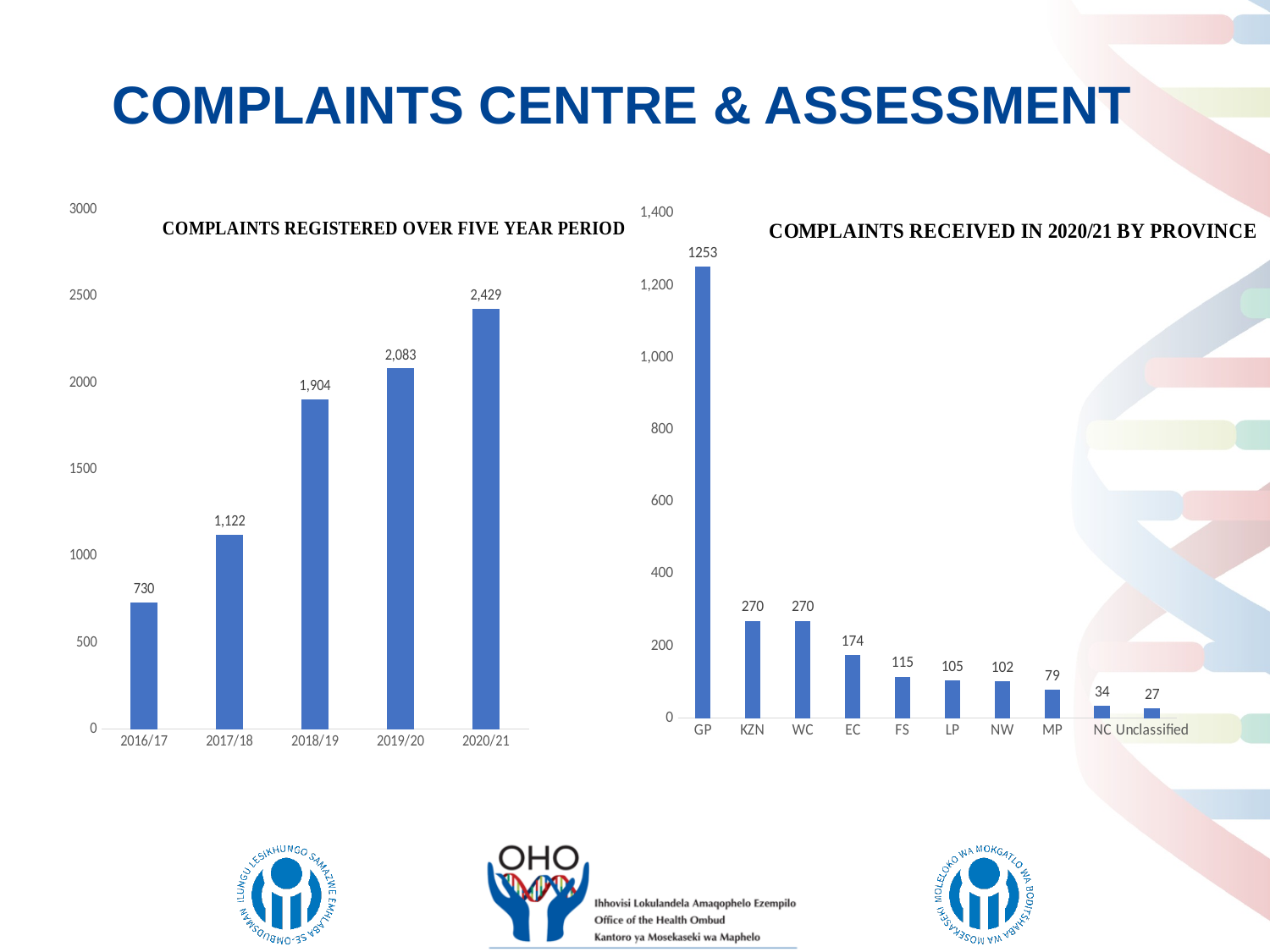
In the 'Complaints registered over five year period' chart, which year has the lowest number of complaints? 2016/17 In the 'Complaints registered over five year period' chart, do the values rise or fall from 2016/17 to 2020/21? rise In the 'Complaints registered over five year period' chart, what is the difference between the 2020/21 and 2019/20 values? 346 In the 'Complaints received in 2020/21 by province' chart, which category has the lowest value? Unclassified In the 'Complaints received in 2020/21 by province' chart, which province has the highest number of complaints? GP In the 'Complaints registered over five year period' chart, how many years are shown? 5 In the 'Complaints received in 2020/21 by province' chart, how many complaints were received from EC? 174 What type of chart is the 'Complaints received in 2020/21 by province' chart? bar chart In the 'Complaints received in 2020/21 by province' chart, what is the difference between the GP and KZN values? 983 In the 'Complaints registered over five year period' chart, how many complaints were registered in 2018/19? 1,904 In the 'Complaints registered over five year period' chart, which year has the highest number of complaints? 2020/21 In the 'Complaints received in 2020/21 by province' chart, which is larger, the value for FS or the value for LP? FS